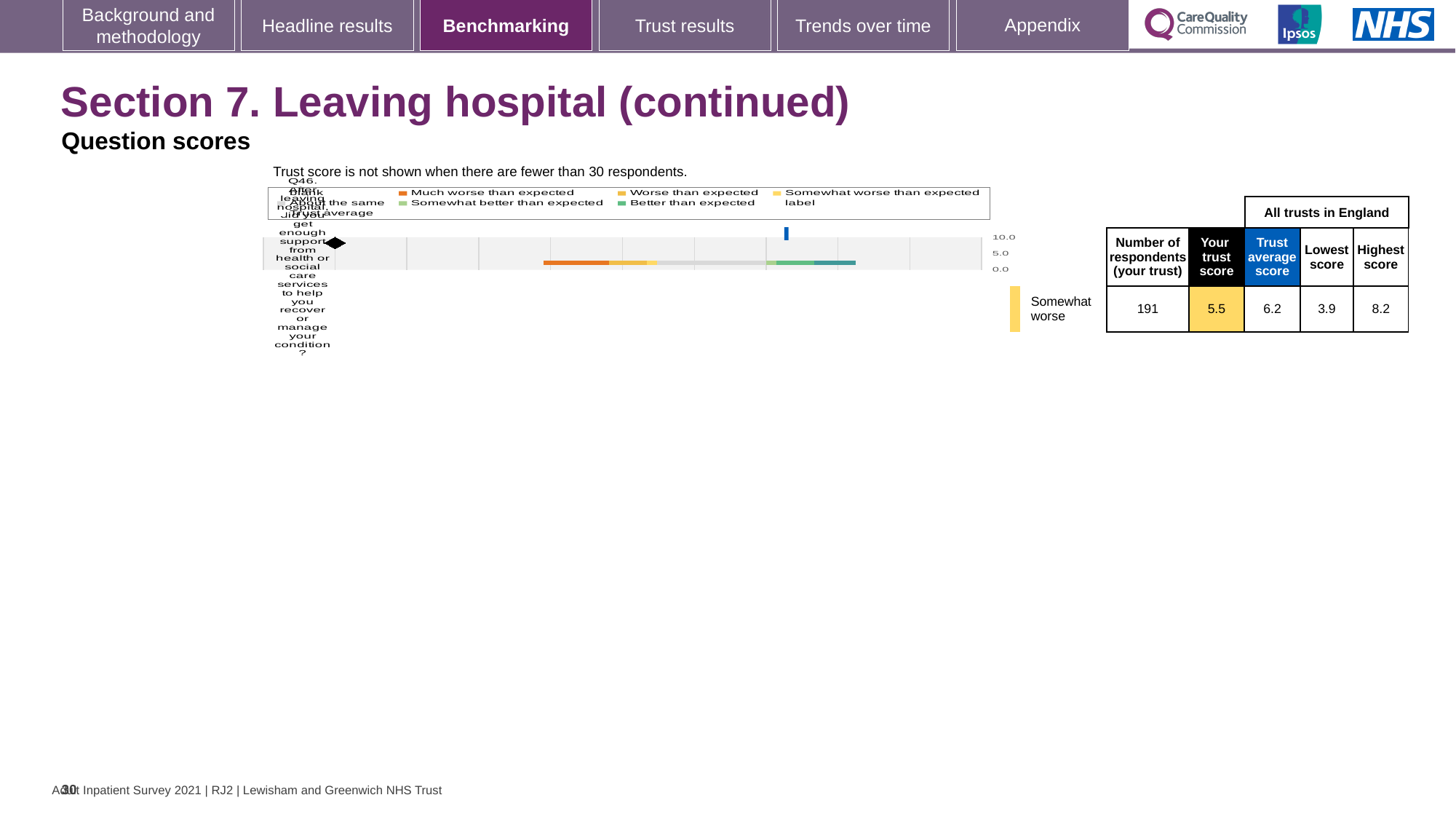
What is the difference between the highest and lowest scores for Q46 across all trusts in England? 4.3 How many respondents from the trust answered Q46? 191 What benchmark category is the trust's Q46 score placed in? Somewhat worse What is the lowest score among all trusts in England for Q46? 3.9 What is the trust average score for Q46 across all trusts in England? 6.2 What is the highest score among all trusts in England for Q46? 8.2 What kind of chart is used to show the Q46 benchmarking result? Bar chart What is the trust's score for Q46 (Did you get enough support from health or social care services to help you recover or manage your condition)? 5.5 Is the trust's score for Q46 greater or less than 5.0 on the chart axis? greater Which is larger for Q46: the trust's own score or the trust average score? Trust average score By how much does the trust average score exceed the trust's own score for Q46? 0.7 Which legend entry is shown in orange on the Q46 chart? Much worse than expected